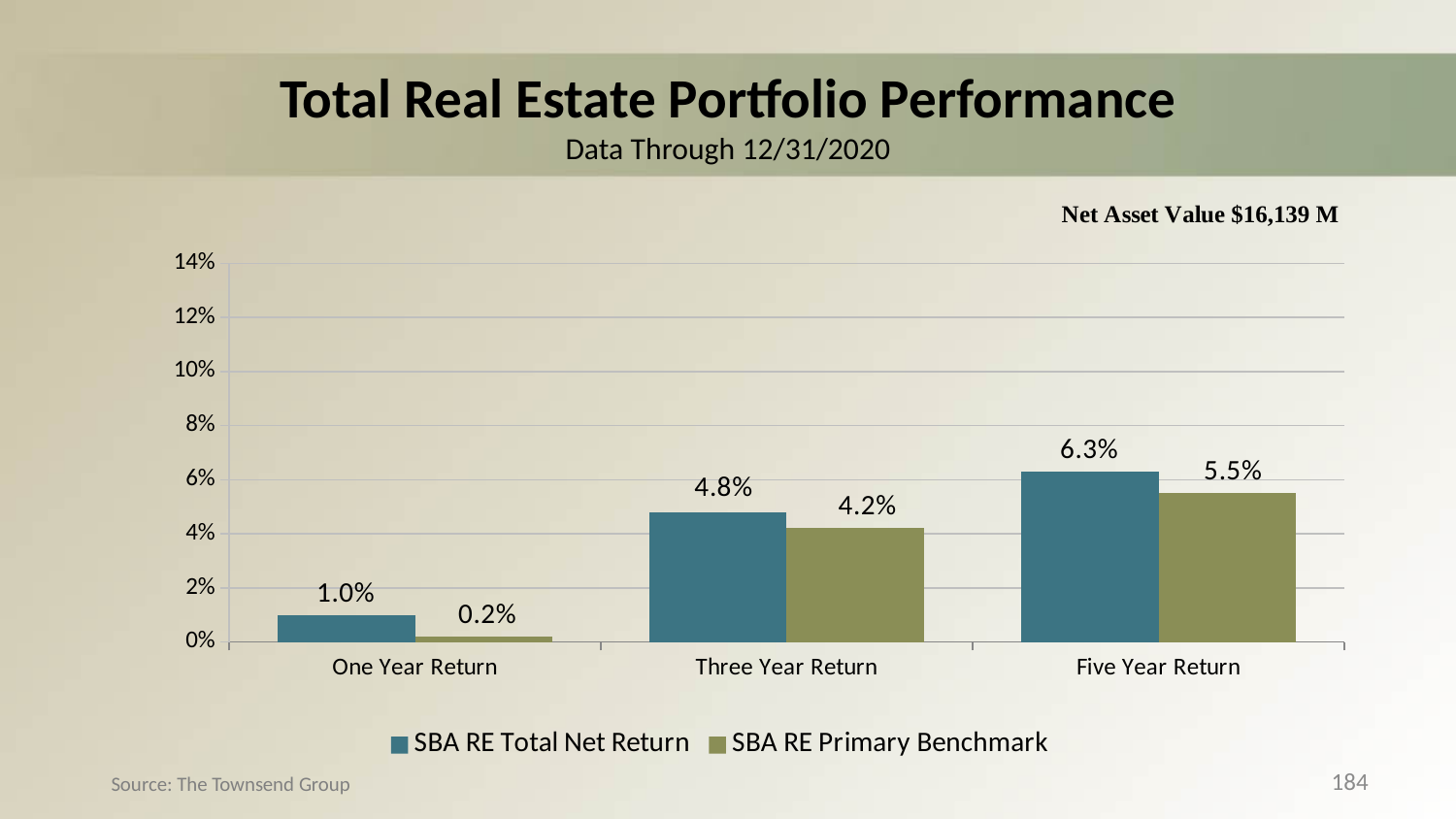
What is the SBA RE Total Net Return for the Five Year Return period? 6.3% How many return periods are shown on the x axis? 3 What kind of chart is shown on the slide? Bar chart How many series does the legend list? 2 What is the SBA RE Total Net Return for the One Year Return period? 1.0% Is the SBA RE Total Net Return for the Five Year Return period greater or less than 8%? less For the Three Year Return period, which is larger: the SBA RE Total Net Return or the SBA RE Primary Benchmark? SBA RE Total Net Return What is the SBA RE Primary Benchmark value for the One Year Return period? 0.2% What is the SBA RE Primary Benchmark value for the Three Year Return period? 4.2% What is the difference between the SBA RE Total Net Return and the SBA RE Primary Benchmark for the Five Year Return period? 0.8% Which period has the lowest SBA RE Primary Benchmark value? One Year Return Which period has the highest SBA RE Total Net Return? Five Year Return